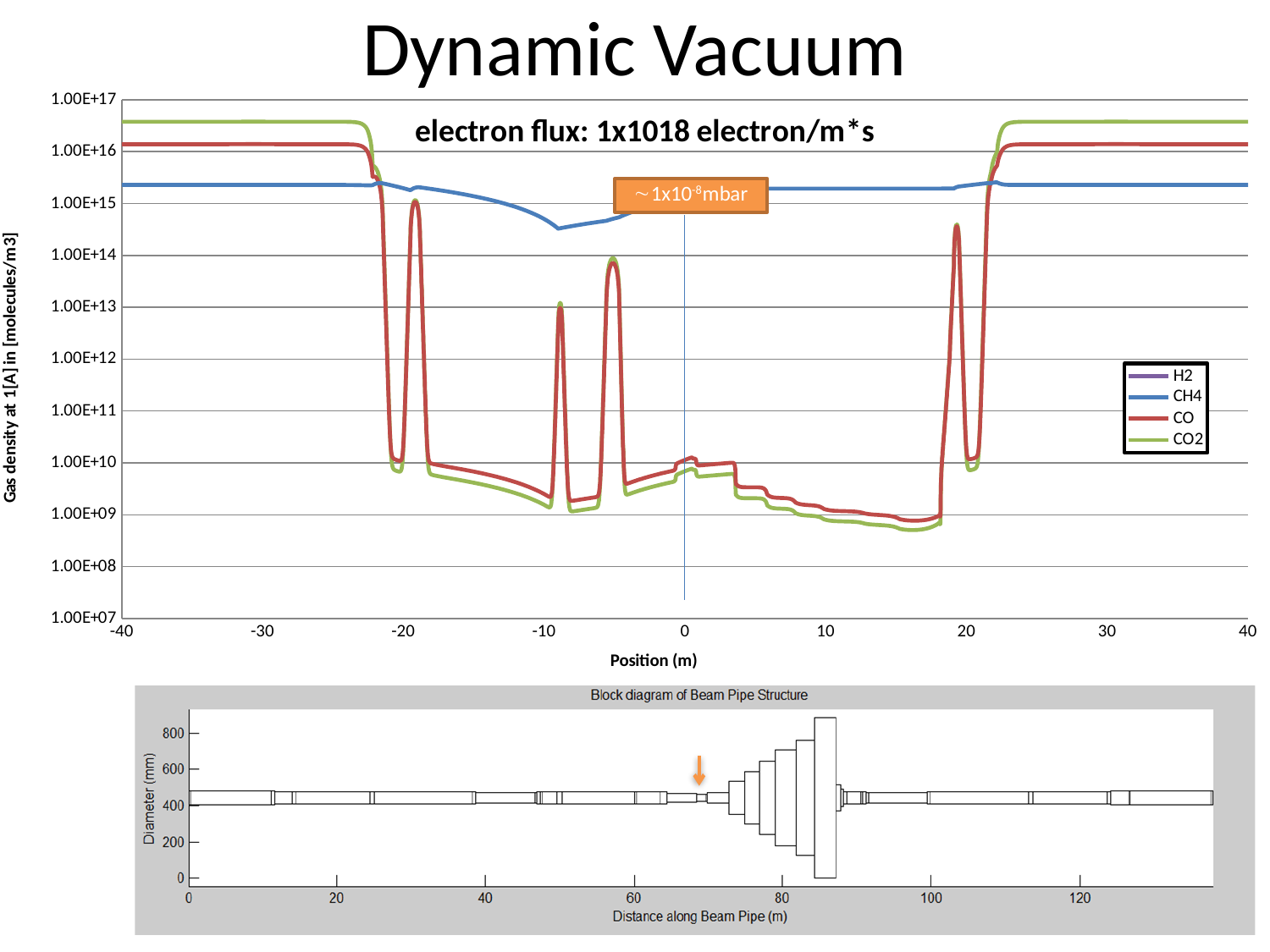
In the main chart, is the CO value at position 10 greater or less than 1.00E+10? less How many series does the legend of the main chart list? 4 What kind of chart is the main chart on the slide? line chart What is the x-axis label of the main chart? Position (m) In the main chart, which series has the highest gas density at position -40? CO2 In the main chart, which series has the lowest gas density at position -40? CH4 In the main chart, is the CH4 value at position -40 greater or less than 1.00E+16? less In the main chart, does the CH4 series rise or fall as position goes from -20 to -10? fall Which series are listed in the legend of the main chart? H2, CH4, CO, CO2 In the main chart, which is larger at position 0: the CH4 value or the CO value? CH4 In the main chart, is the CO2 value at position 30 greater or less than 1.00E+17? less